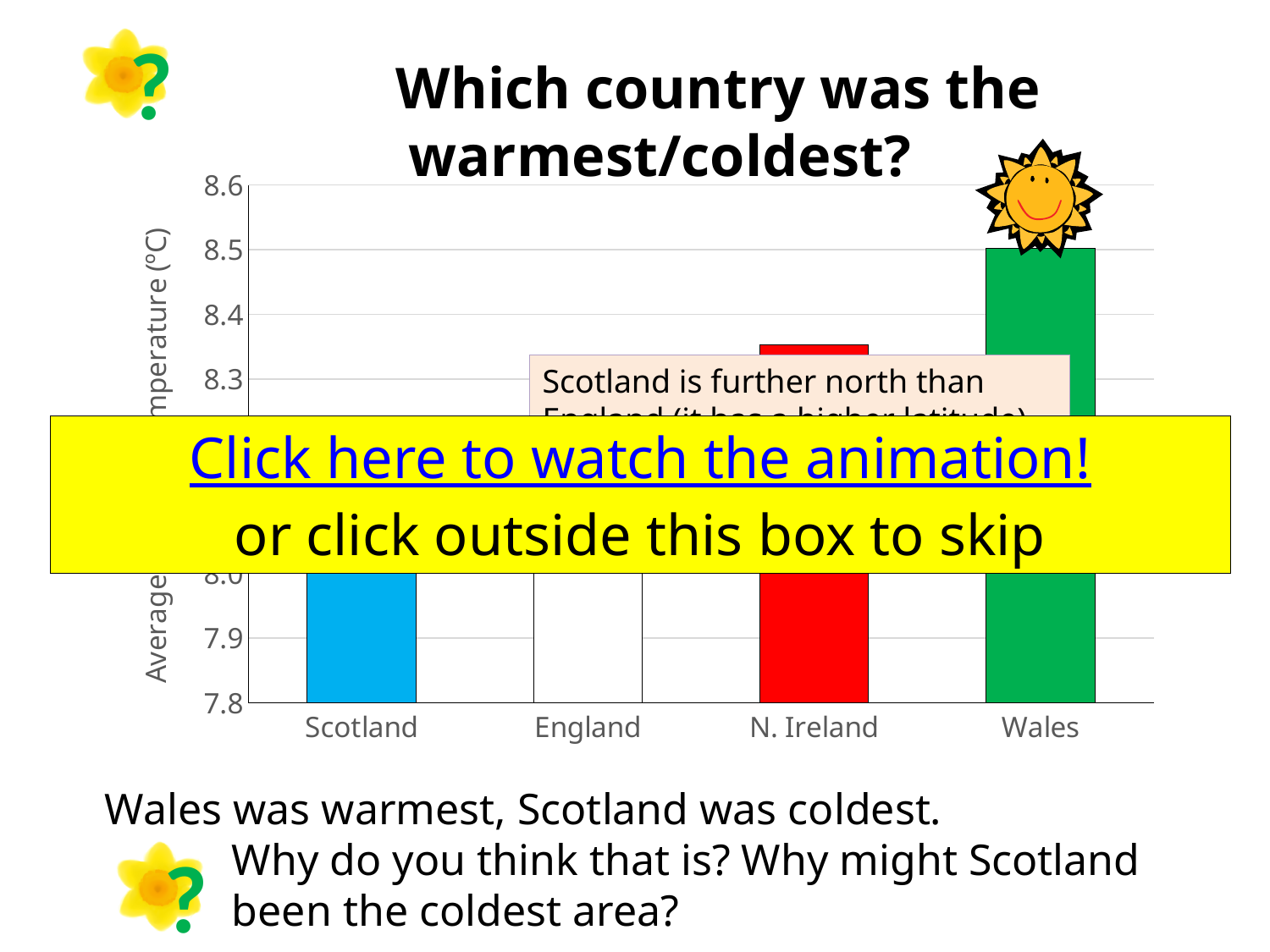
Which has the higher average temperature, Wales or N. Ireland? Wales Is the value for N. Ireland greater or less than 8.4? less Which country has the highest average temperature in the chart? Wales How many countries are shown on the x axis of the chart? 4 Which country has the lowest average temperature in the chart? Scotland What colour is the bar for Wales? green Is the value for N. Ireland greater or less than 8.3? greater What kind of chart is shown on the slide? bar chart What is the title of the chart on the slide? Which country was the warmest/coldest? What is the average temperature for Wales in the chart? 8.5